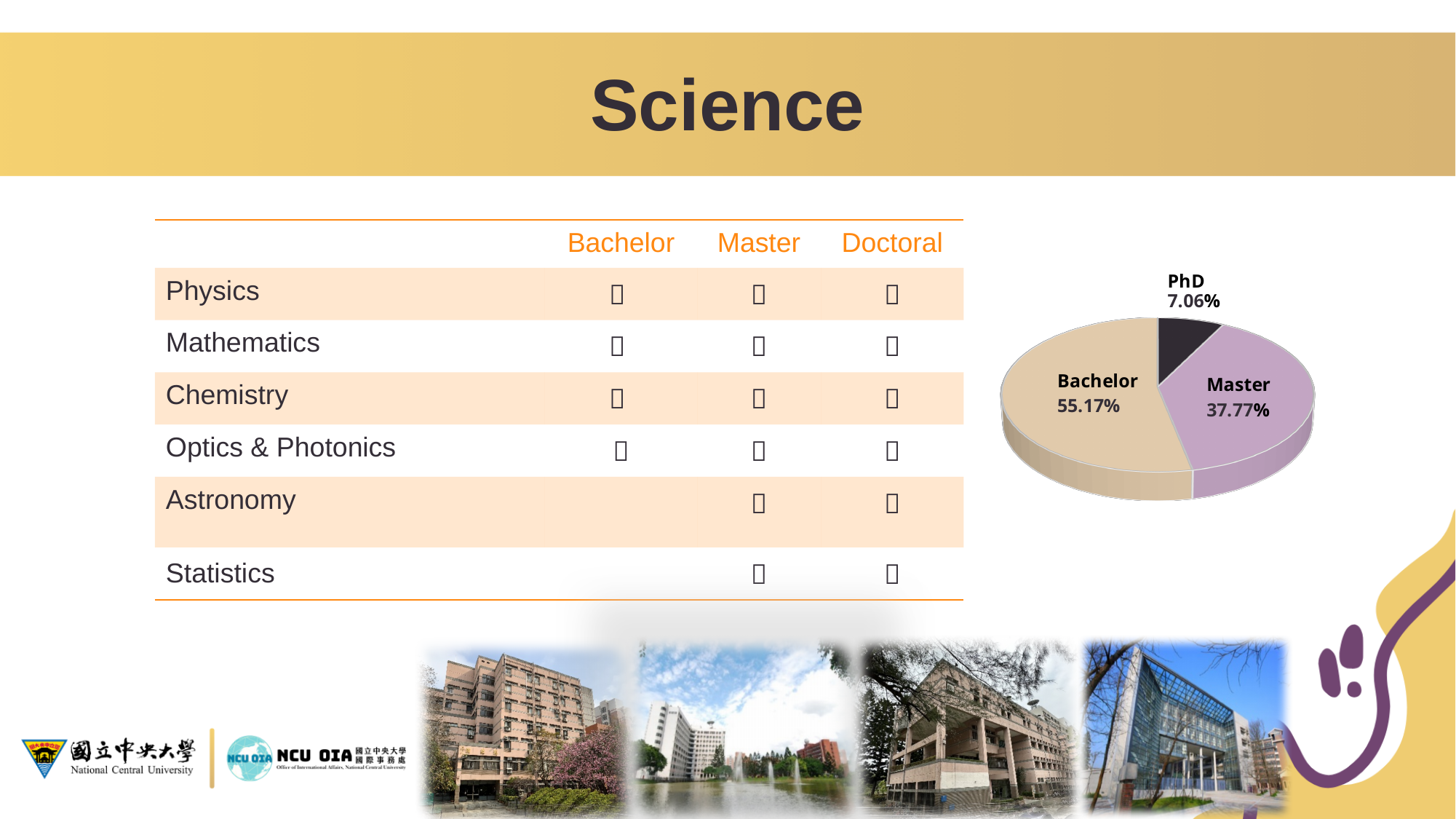
How many slices does the pie chart have? 3 Which slice of the pie chart is the smallest? PhD What is the difference between the Master and PhD shares in the pie chart? 30.71% What colour is the Master slice in the pie chart? purple What share of the pie chart does Bachelor represent? 55.17% Which slice of the pie chart is the largest? Bachelor Which is larger in the pie chart, Master or PhD? Master What kind of chart is shown on the slide? pie chart Is the Bachelor share in the pie chart greater or less than 50%? greater What share of the pie chart does PhD represent? 7.06% What share of the pie chart does Master represent? 37.77% What is the difference between the Bachelor and Master shares in the pie chart? 17.40%